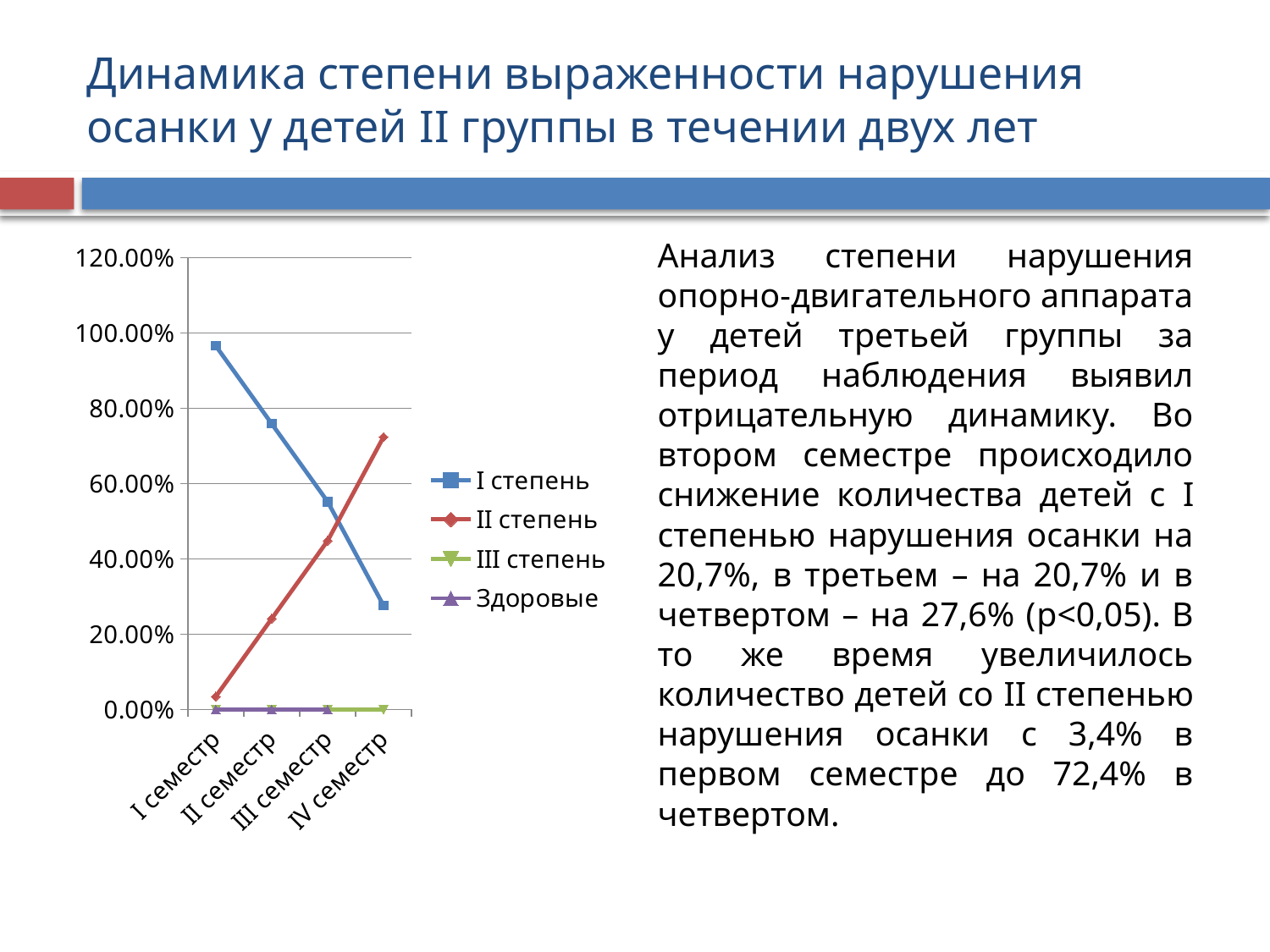
How many categories (semesters) are plotted on the x axis? 4 Does the value for I степень rise or fall from I семестр to IV семестр? fall Is the value for II степень in IV семестр greater or less than 60.00%? greater What kind of chart is shown on the slide? line chart In III семестр, which is larger: the value for I степень or the value for II степень? I степень In which semester is the value for II степень highest? IV семестр Does the value for II степень rise or fall from I семестр to IV семестр? rise In which semester is the value for I степень lowest? IV семестр Is the value for II степень in I семестр greater or less than 20.00%? less In which semester is the value for I степень highest? I семестр How many series does the legend list? 4 Is the value for I степень in I семестр greater or less than 80.00%? greater